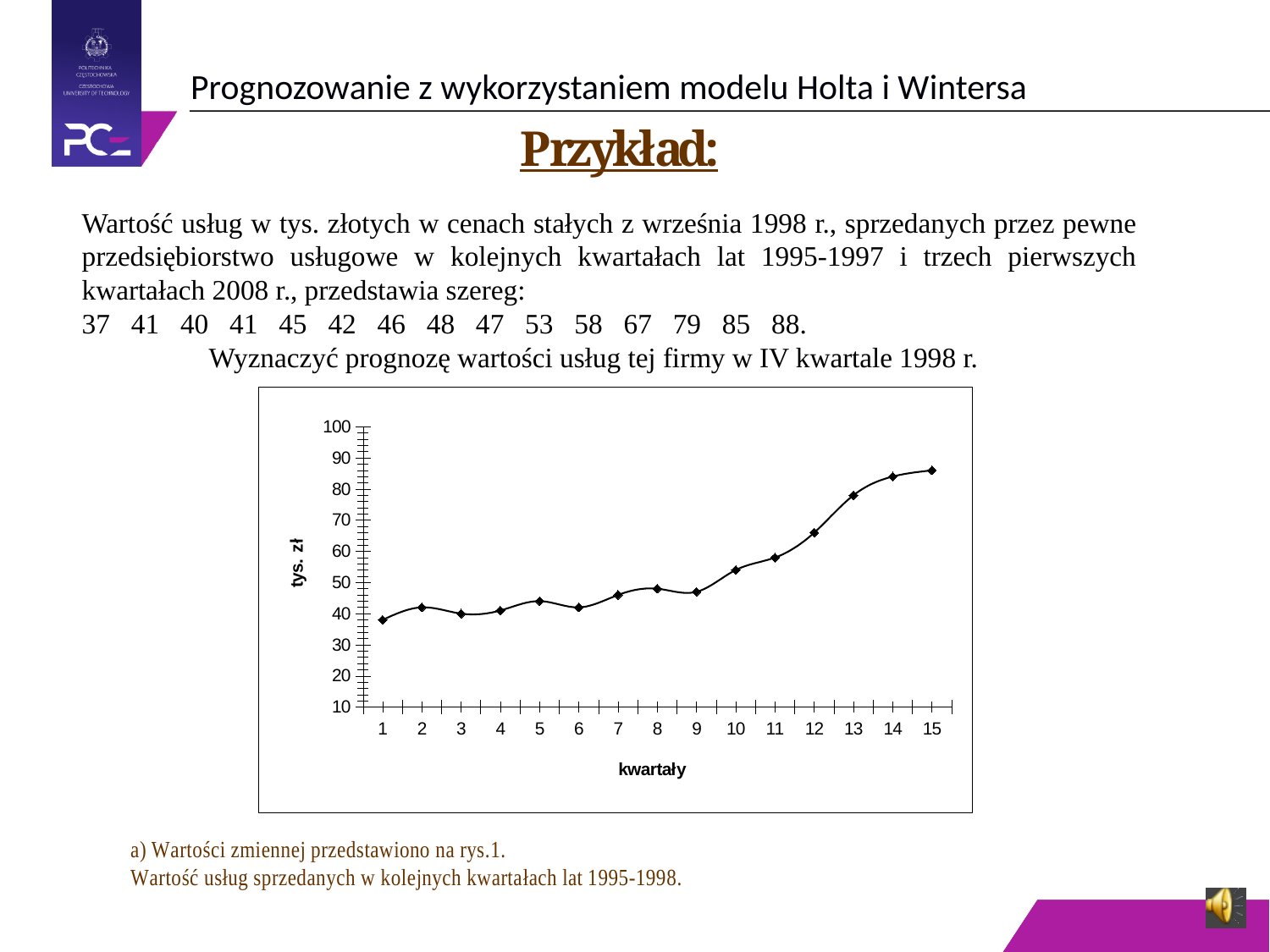
Which quarter has the highest value on the chart? 15 What is the title of the vertical axis? tys. zł What kind of chart is shown on the slide? line chart Which quarter has the lowest value on the chart? 1 Is the value for quarter 12 greater or less than 60? greater How many quarters (data points) are plotted on the chart? 15 Is the value for quarter 5 greater or less than 50? less Do the values generally rise or fall from quarter 1 to quarter 15? rise Which is larger, the value for quarter 13 or the value for quarter 9? quarter 13